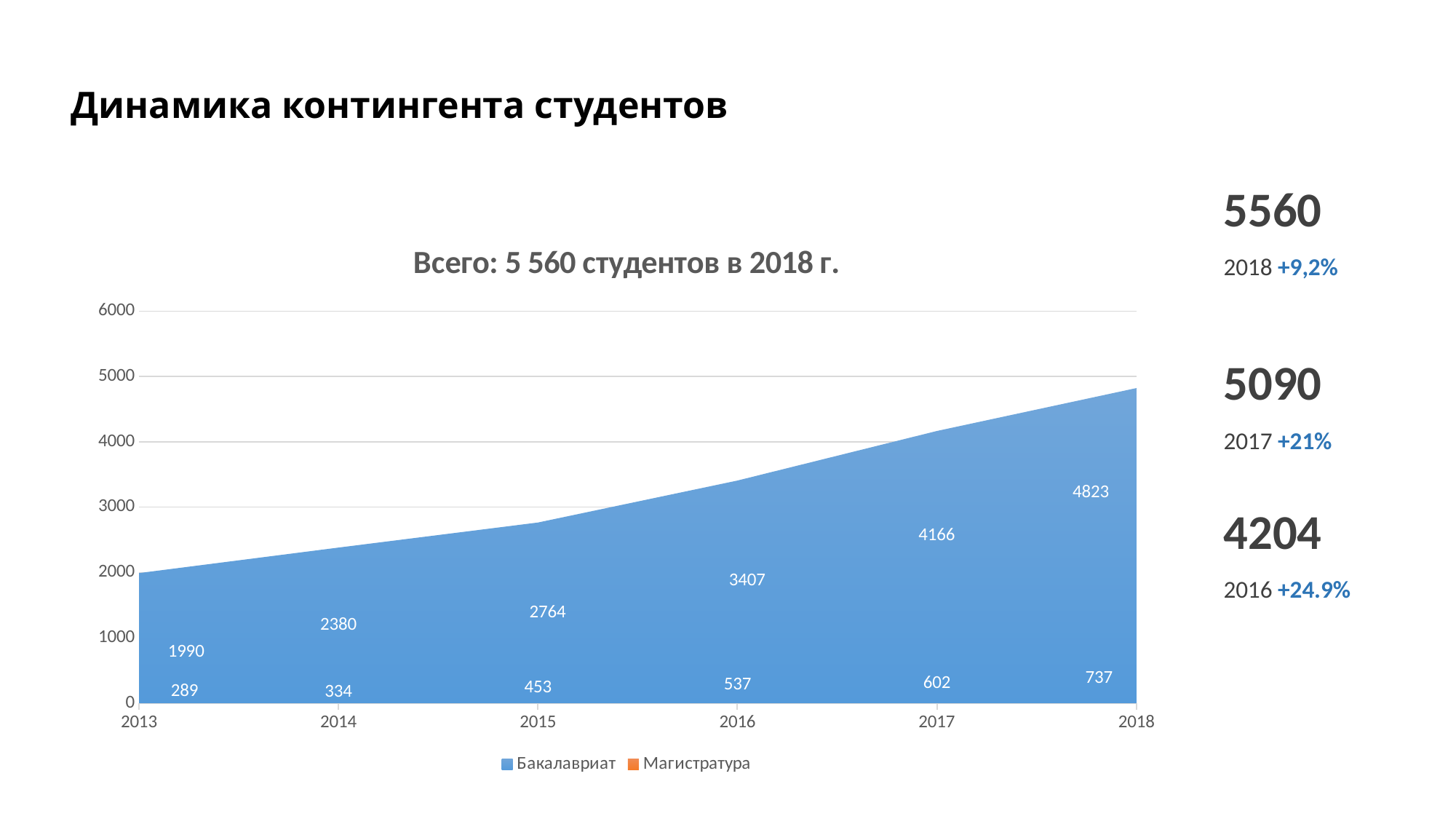
Which is larger: the Магистратура value for 2016 or for 2017? 2017 Do the Бакалавриат values rise or fall from 2013 to 2018? Rise What is the value for Бакалавриат in 2013? 1990 What is the value for Магистратура in 2015? 453 In which year is the Магистратура value lowest? 2013 What is the value for Бакалавриат in 2018? 4823 How many series does the legend list? 2 In which year is the Бакалавриат value highest? 2018 What is the value for Магистратура in 2018? 737 What is the difference between the Бакалавриат values for 2017 and 2016? 759 How many years are shown on the x axis? 6 What kind of chart is shown on the slide? Area chart